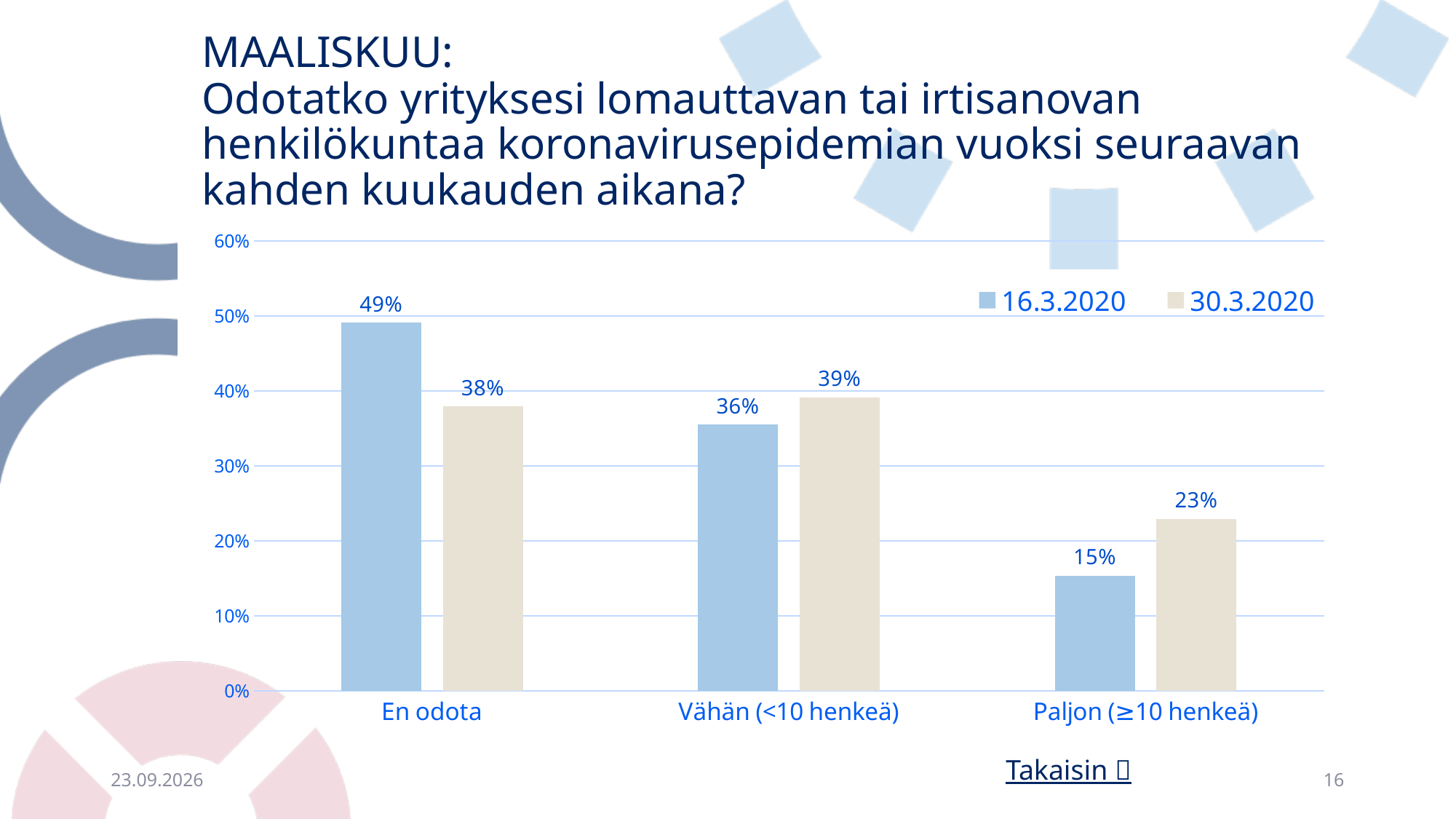
What kind of chart is shown on the slide? Bar chart What are the two series names listed in the legend? 16.3.2020 and 30.3.2020 Which category has the highest value in the 16.3.2020 series? En odota Which category has the lowest value in the 30.3.2020 series? Paljon (≥10 henkeä) What is the difference between the 16.3.2020 and 30.3.2020 values for "En odota"? 11 percentage points What is the value for "Paljon (≥10 henkeä)" in the 30.3.2020 series? 23% For "Paljon (≥10 henkeä)", which series has the larger value, 16.3.2020 or 30.3.2020? 30.3.2020 What is the value for "En odota" in the 16.3.2020 series? 49% How many categories are shown on the x axis? 3 How many series does the legend list? 2 Is the 30.3.2020 value for "Vähän (<10 henkeä)" greater or less than 30%? greater What is the value for "Vähän (<10 henkeä)" in the 16.3.2020 series? 36%